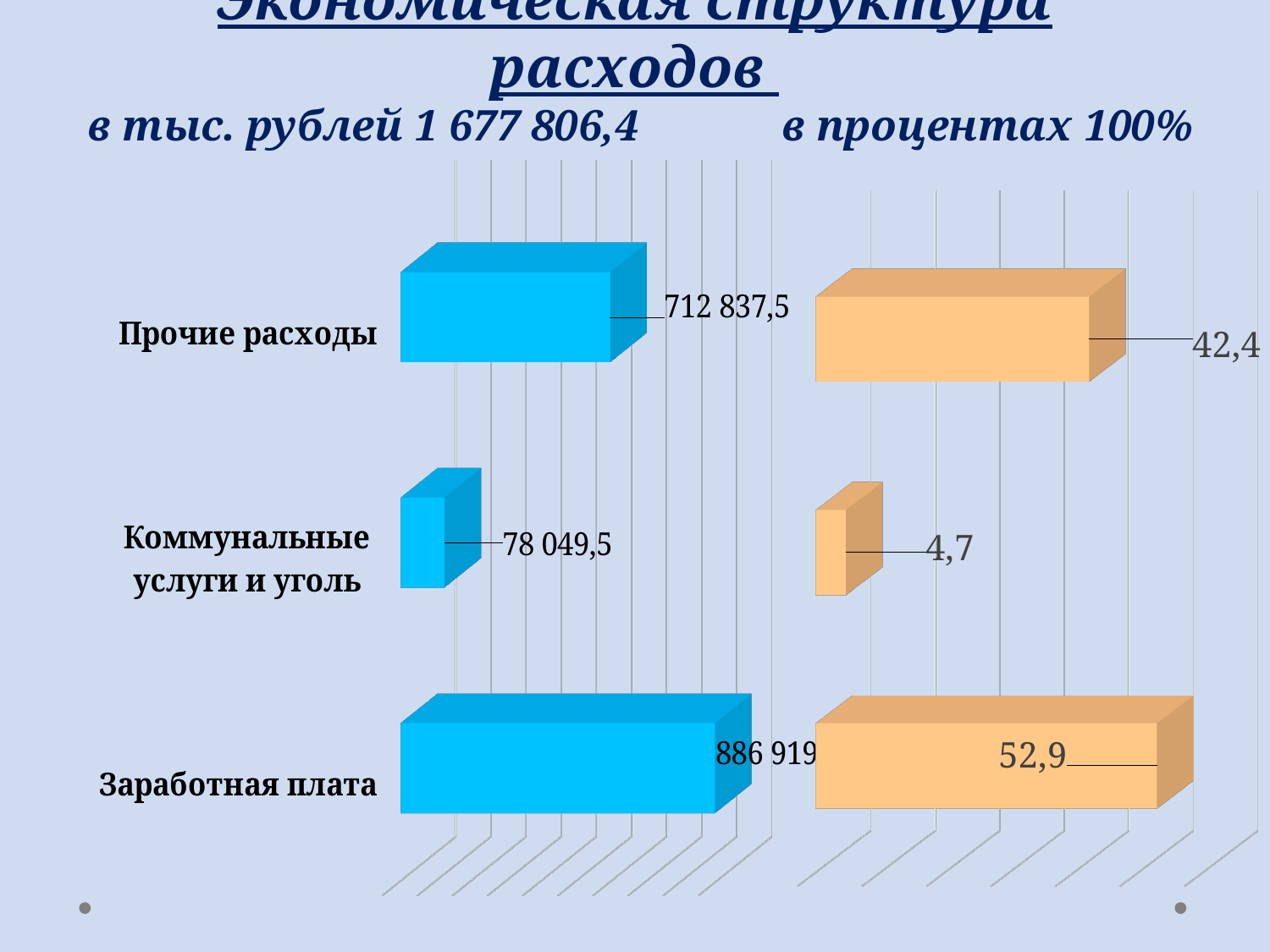
On the right chart (в процентах), what is the value for Прочие расходы? 42,4 On the right chart (в процентах), which category has the lowest value? Коммунальные услуги и уголь On the right chart (в процентах), what is the value for Заработная плата? 52,9 On the left chart (в тыс. рублей), what is the value for Прочие расходы? 712 837,5 On the left chart (в тыс. рублей), what is the value for Заработная плата? 886 919 On the left chart (в тыс. рублей), which category has the highest value? Заработная плата How many categories are shown on the left chart (в тыс. рублей)? 3 On the left chart (в тыс. рублей), what is the difference between Заработная плата and Прочие расходы? 174 081,5 What type of chart is the right chart (в процентах)? Bar chart On the right chart (в процентах), which is larger: Прочие расходы or Заработная плата? Заработная плата On the right chart (в процентах), what is the value for Коммунальные услуги и уголь? 4,7 On the left chart (в тыс. рублей), what is the value for Коммунальные услуги и уголь? 78 049,5